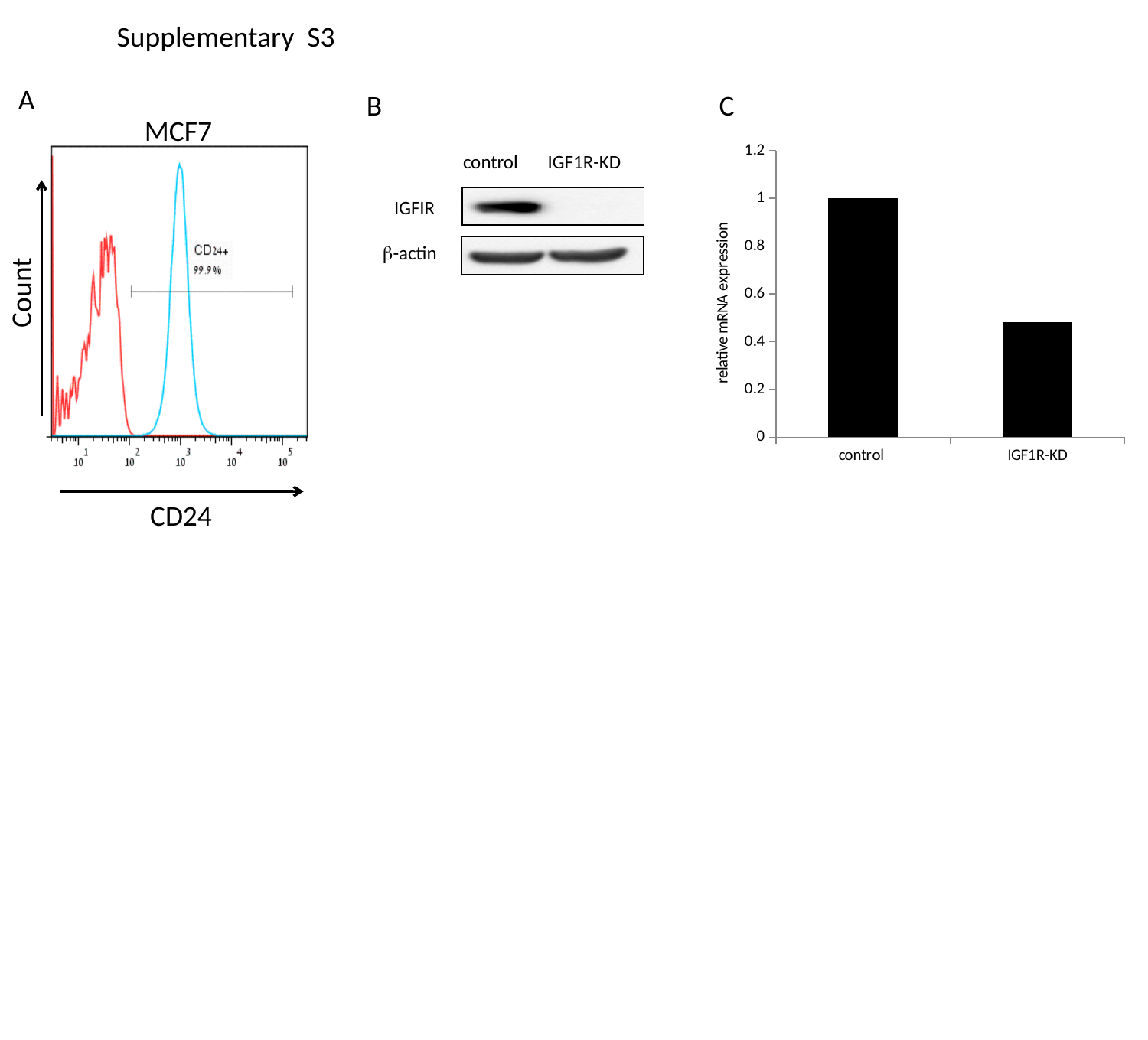
In the bar chart in panel C, what is the relative mRNA expression for control? 1 In the bar chart in panel C, which category has the lowest relative mRNA expression? IGF1R-KD What is the maximum value shown on the y-axis of the bar chart in panel C? 1.2 In the bar chart in panel C, is the value for IGF1R-KD greater or less than 0.6? less In the bar chart in panel C, do the values rise or fall from control to IGF1R-KD? fall What is the y-axis label of the bar chart in panel C? relative mRNA expression In the bar chart in panel C, which category has the highest relative mRNA expression? control In the histogram in panel A, what percentage is shown for the CD24+ gate? 99.9% In the bar chart in panel C, is the value for IGF1R-KD greater or less than 0.4? greater What kind of chart is shown in panel C? bar chart In the bar chart in panel C, which is larger, the value for control or for IGF1R-KD? control How many categories are shown in the bar chart in panel C? 2